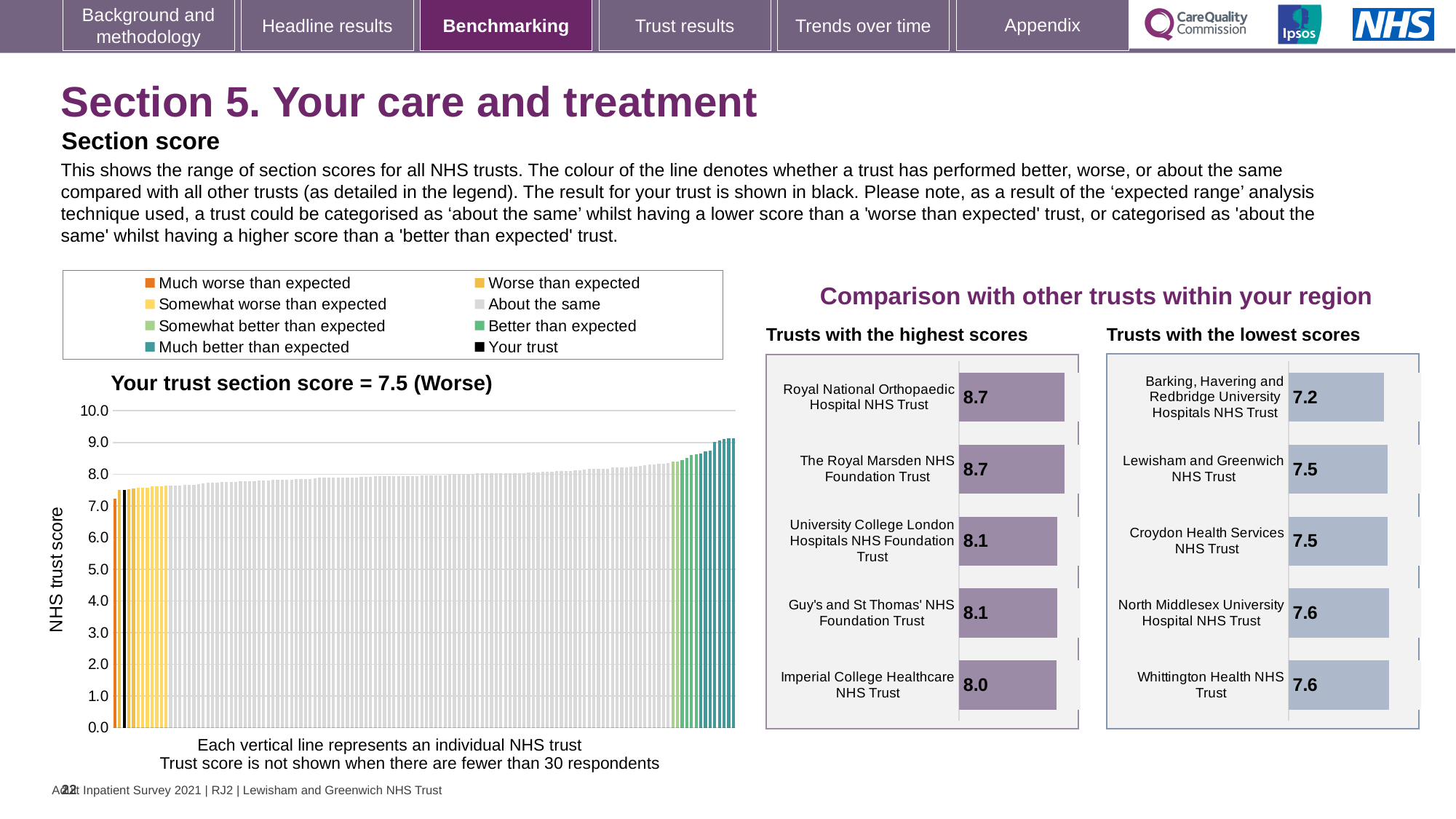
What kind of chart is the 'Your trust section score' chart? Bar chart In the 'Trusts with the lowest scores' chart, which trust has the lowest score? Barking, Havering and Redbridge University Hospitals NHS Trust In the 'Trusts with the highest scores' chart, how many trusts are shown? 5 In the 'Trusts with the lowest scores' chart, which has the higher score: Croydon Health Services NHS Trust or Whittington Health NHS Trust? Whittington Health NHS Trust In the 'Trusts with the lowest scores' chart, what is the score for Barking, Havering and Redbridge University Hospitals NHS Trust? 7.2 In the 'Your trust section score' chart, how is your trust's score categorised, as shown in the chart title? Worse In the 'Trusts with the highest scores' chart, which trust has the lowest score? Imperial College Healthcare NHS Trust In the 'Trusts with the highest scores' chart, what is the difference between the score for Royal National Orthopaedic Hospital NHS Trust and the score for Imperial College Healthcare NHS Trust? 0.7 In the 'Trusts with the highest scores' chart, what is the score for Imperial College Healthcare NHS Trust? 8.0 How many entries does the legend above the 'Your trust section score' chart list? 8 In the 'Your trust section score' chart, do the trust scores rise or fall from left to right along the x axis? Rise In the 'Your trust section score' chart, what is the section score for your trust? 7.5